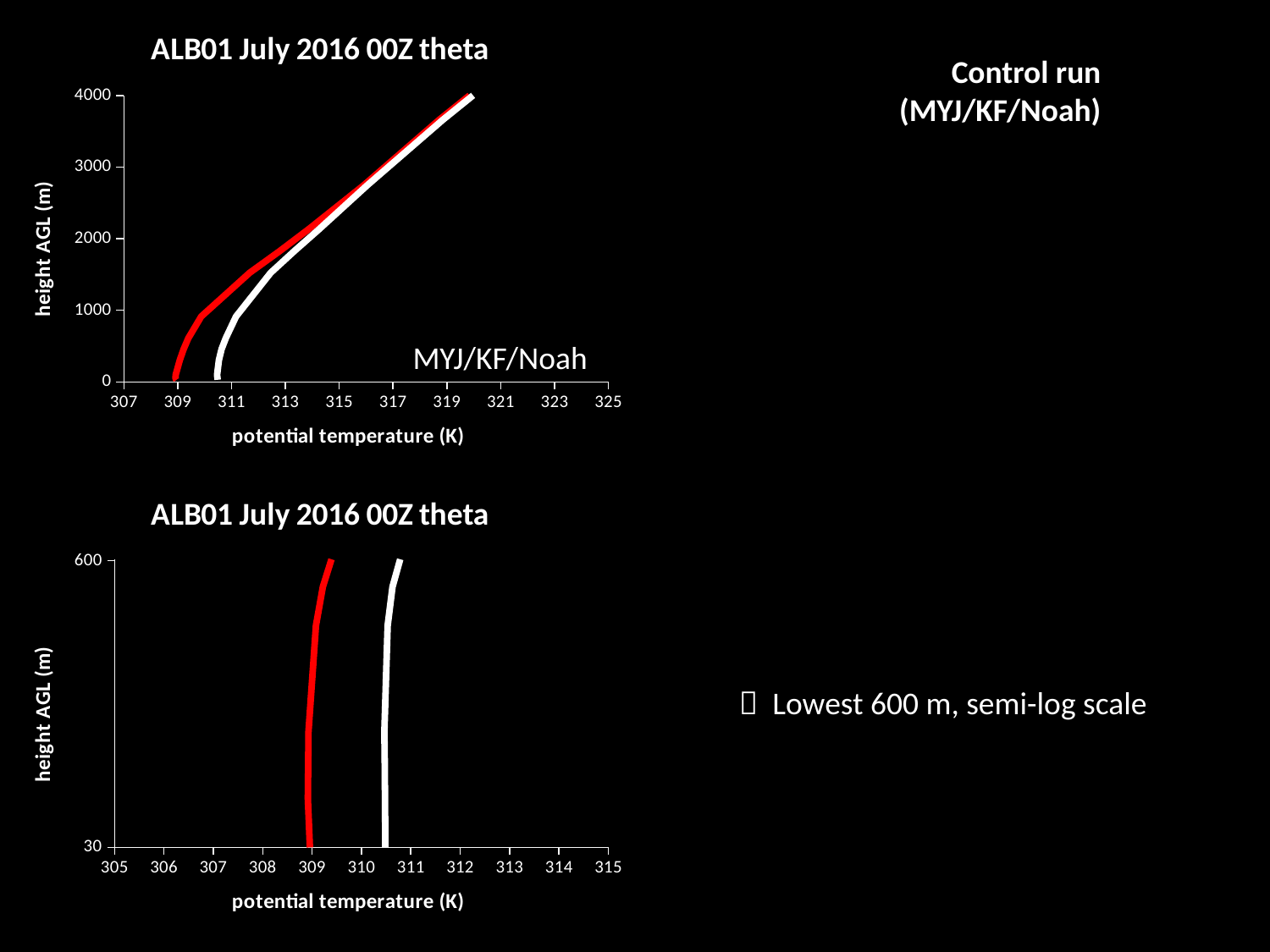
What is the title of the top chart? ALB01 July 2016 00Z theta In the top chart, does potential temperature increase or decrease as height increases? increase In the bottom chart, which line has the higher potential temperature at 600 m height, the red line or the white line? white line How many lines are plotted in the bottom chart? 2 In the bottom chart, is the potential temperature of the red line at 30 m height greater or less than 310 K? less In the top chart, is the potential temperature of the red line at 0 m height greater or less than 311 K? less In the top chart, is the potential temperature of the red line at 4000 m height greater or less than 317 K? greater What is the x-axis label of the bottom chart? potential temperature (K) In the top chart, which line has the higher potential temperature at 0 m height, the red line or the white line? white line What type of chart is the top chart on the slide? line chart